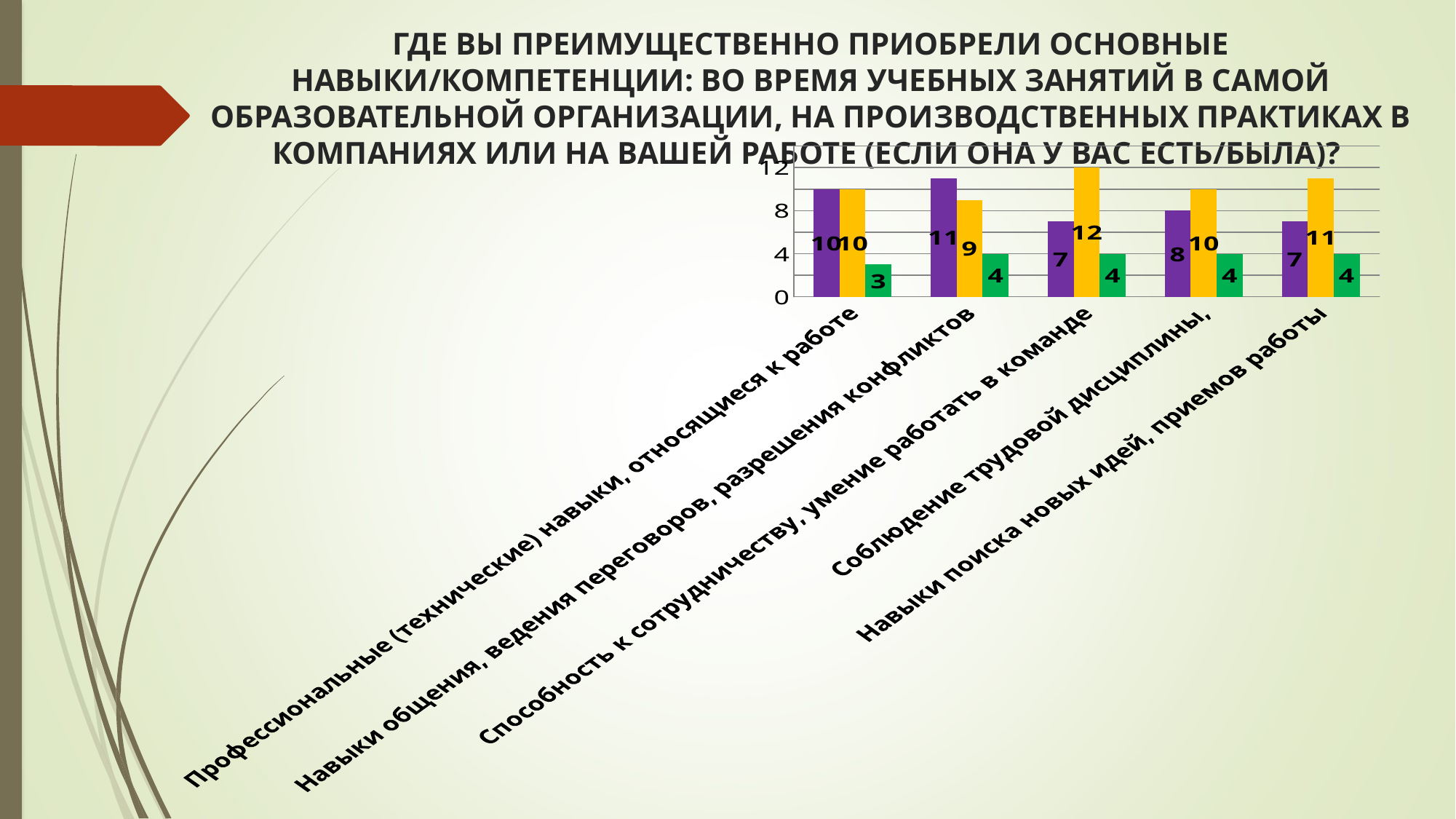
For 'Соблюдение трудовой дисциплины', which is larger: the purple bar or the yellow bar? the yellow bar How many categories are shown on the x axis of the chart? 5 Which category has the highest yellow bar? Способность к сотрудничеству, умение работать в команде Which category has the lowest green bar? Профессиональные (технические) навыки, относящиеся к работе What is the value of the green bar for 'Профессиональные (технические) навыки, относящиеся к работе'? 3 What is the value of the purple bar for 'Профессиональные (технические) навыки, относящиеся к работе'? 10 What kind of chart is shown on the slide? bar chart How many bars are shown for each category in the chart? 3 What is the value of the yellow bar for 'Способность к сотрудничеству, умение работать в команде'? 12 What is the difference between the yellow and purple bars for 'Способность к сотрудничеству, умение работать в команде'? 5 What is the value of the purple bar for 'Навыки общения, ведения переговоров, разрешения конфликтов'? 11 What is the total of the three bars for 'Навыки поиска новых идей, приемов работы'? 22